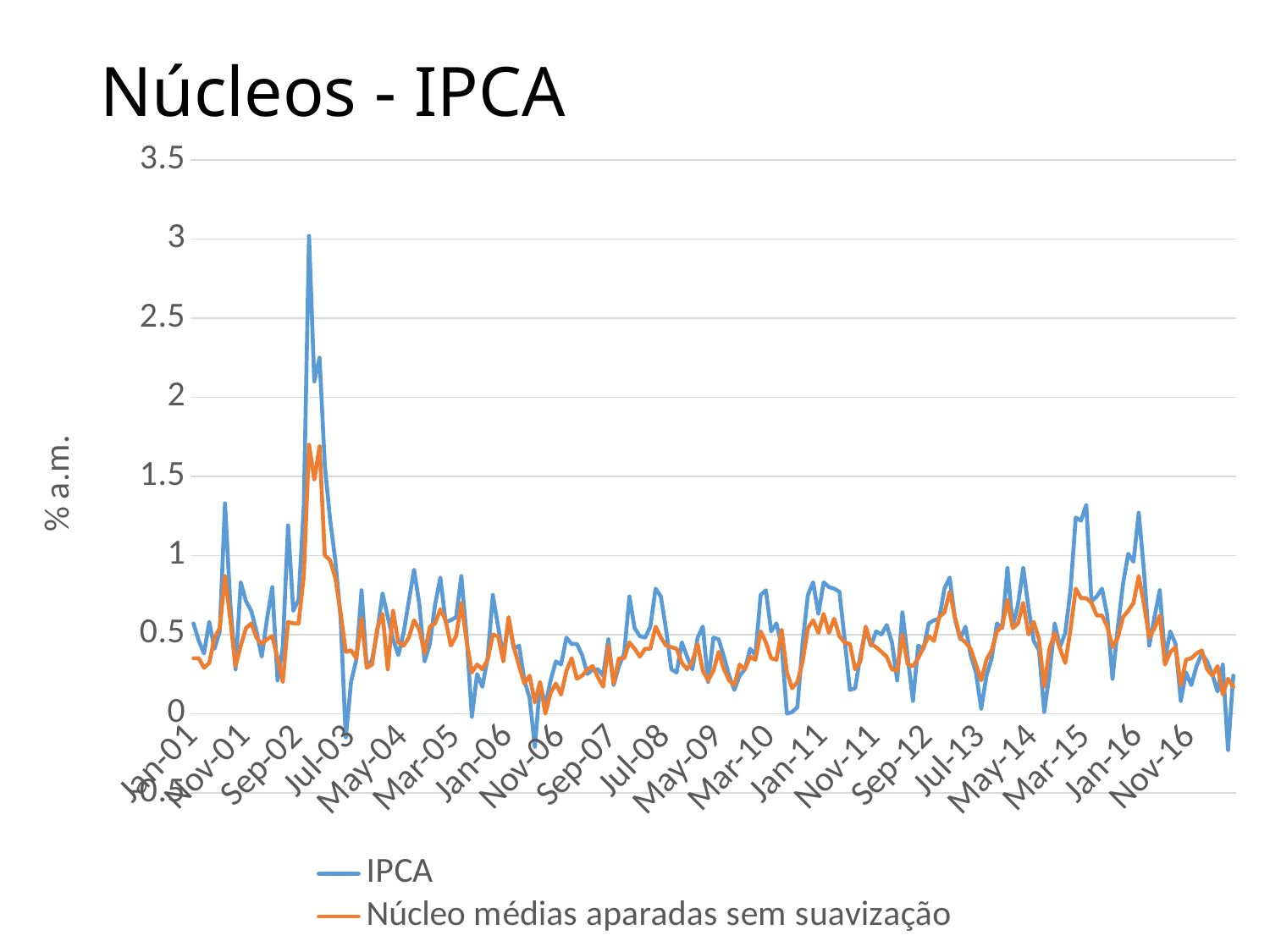
What kind of chart is shown on the slide? line chart What is the title of the chart? Núcleos - IPCA Which series reaches the higher peak, IPCA or Núcleo médias aparadas sem suavização? IPCA How many series does the legend list? 2 How many labels are shown on the x axis? 20 Is the highest value reached by the IPCA series greater or less than 2.5? greater Between which two x-axis labels does the IPCA series reach its highest value? Sep-02 and Jul-03 What is the label on the vertical axis? % a.m. Is the IPCA value at Jan-01 greater or less than 1? less Is the highest value reached by the Núcleo médias aparadas sem suavização series greater or less than 2? less